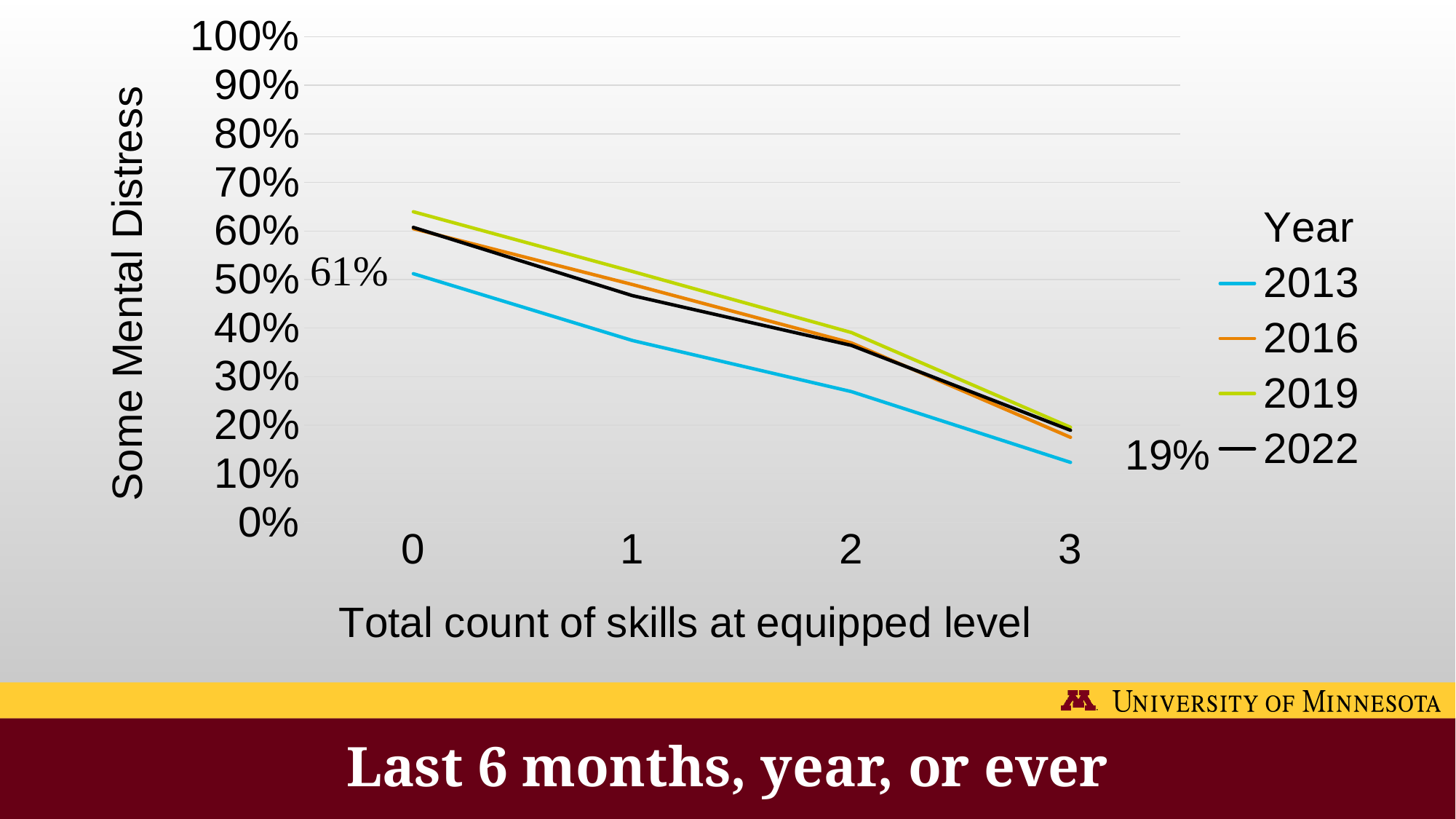
What data label is printed at the right end of the lines, at a skill count of 3? 19% What kind of chart is shown on the slide? line chart Which year has the highest value at a skill count of 0? 2019 Is the value for 2019 at a skill count of 0 greater or less than 60%? greater Do the values for Some Mental Distress rise or fall as the total count of skills at equipped level increases? fall How many points are on the x axis (Total count of skills at equipped level)? 4 What is the title of the legend? Year Which year has the lowest value at a skill count of 3? 2013 How many series does the legend list? 4 At a skill count of 0, which is larger: the value for 2019 or the value for 2013? 2019 Is the value for 2013 at a skill count of 0 greater or less than 60%? less Is the value for 2013 at a skill count of 3 greater or less than 20%? less